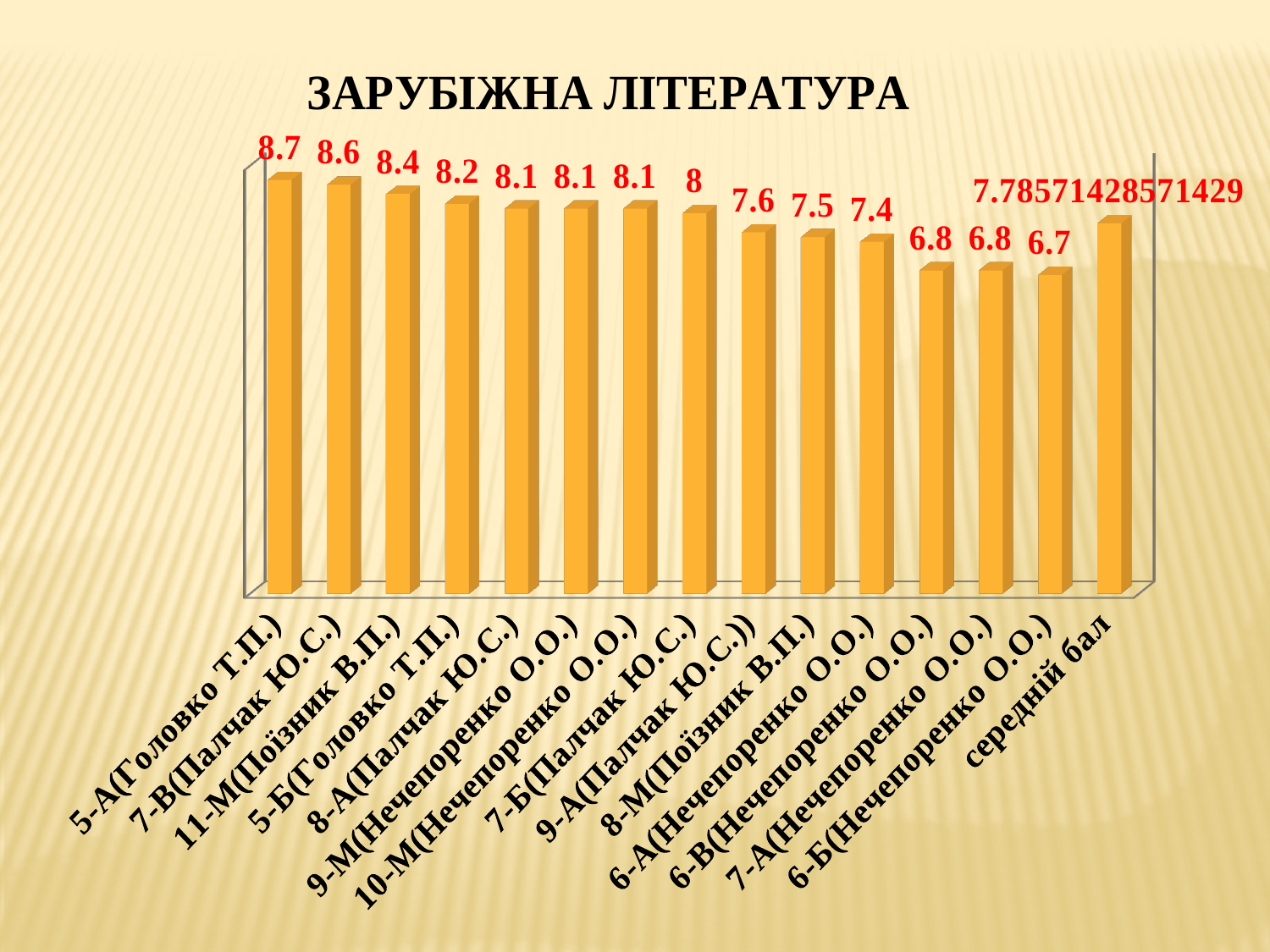
What is the title of the chart? ЗАРУБІЖНА ЛІТЕРАТУРА What is the value for 6-Б(Нечепоренко О.О.)? 6.7 What is the difference between the values for 11-М(Поізник В.П.) and 6-А(Нечепоренко О.О.)? 1 Which category has the highest value? 5-А(Головко Т.П.) What is the value shown for середній бал? 7.78571428571429 Which category has the lowest value? 6-Б(Нечепоренко О.О.) How many bars are plotted in the chart? 15 What is the difference between the values for 5-А(Головко Т.П.) and 6-Б(Нечепоренко О.О.)? 2 What is the value for 8-М(Поізник В.П.)? 7.5 What kind of chart is shown on the slide? bar chart Which is larger, the value for 7-В(Палчак Ю.С.) or the value for 9-А(Палчак Ю.С.))? 7-В(Палчак Ю.С.) What is the value for 5-А(Головко Т.П.)? 8.7